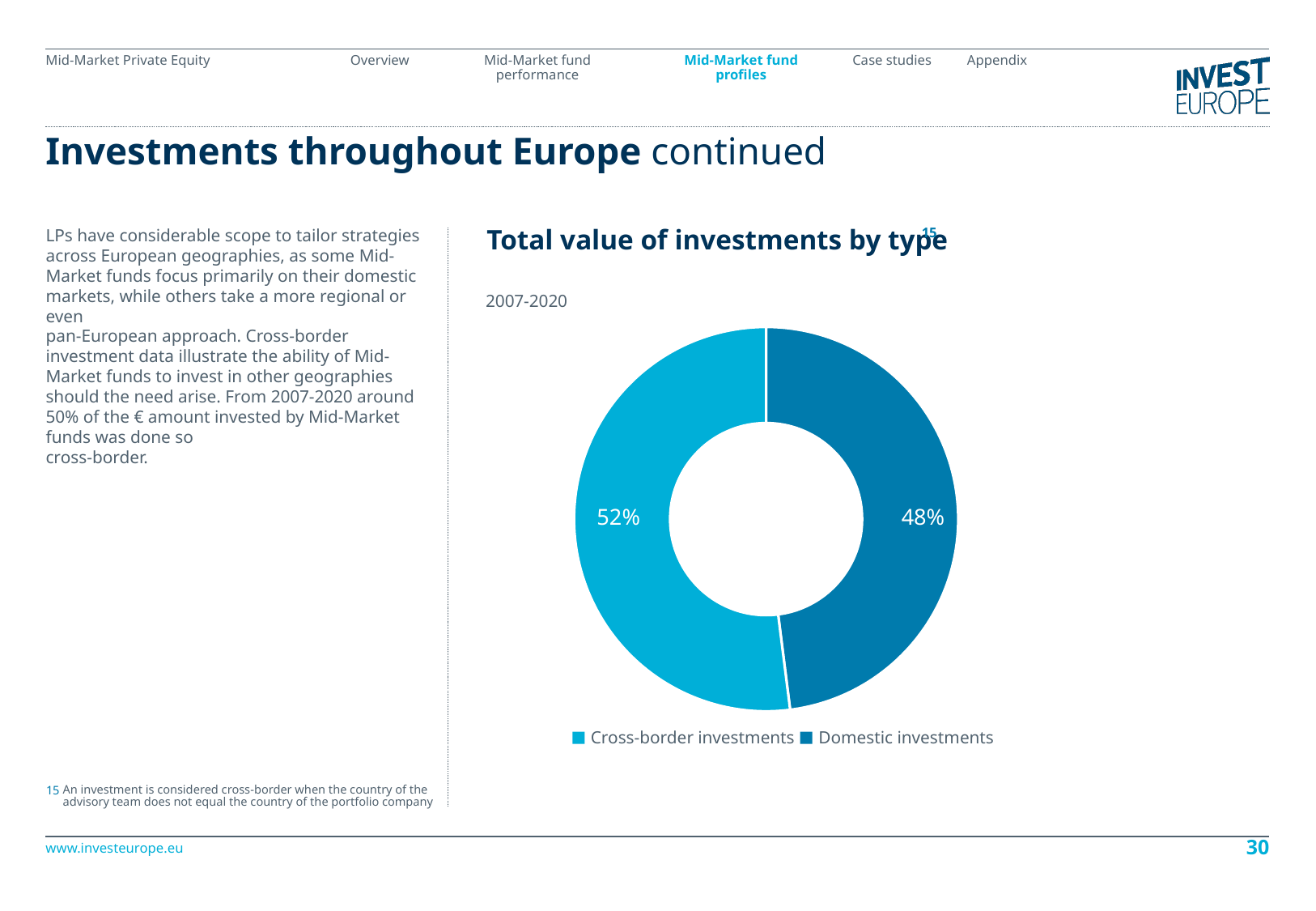
What kind of chart is shown on the slide? Doughnut (pie) chart Is the share for domestic investments greater or less than 50%? less What share of the total value of investments is domestic investments? 48% Which investment type has the smaller share of total value? Domestic investments Is the share for cross-border investments larger or smaller than the share for domestic investments? Larger What share of the total value of investments is cross-border investments? 52% What time period does the chart cover? 2007-2020 What is the difference in percentage points between the cross-border and domestic investment shares? 4 percentage points Which investment type has the larger share of total value? Cross-border investments How many categories does the chart show? 2 What is the combined share of cross-border and domestic investments? 100% What is the title of the chart? Total value of investments by type